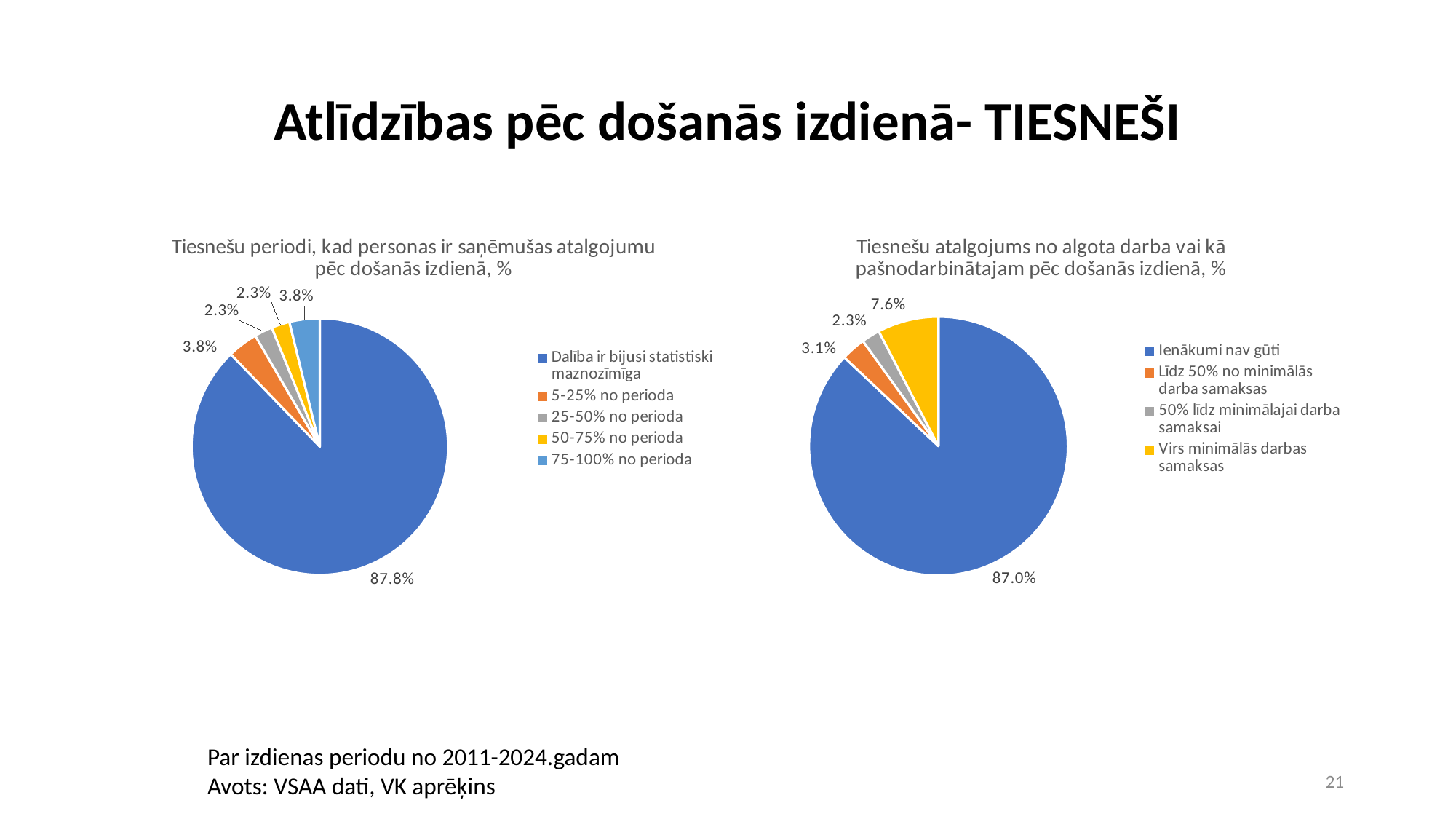
In the left chart, what share is shown for '5-25% no perioda'? 3.8% In the right chart (Tiesnešu atalgojums no algota darba vai kā pašnodarbinātajam pēc došanās izdienā, %), what share is shown for 'Ienākumi nav gūti'? 87.0% What type of chart is used on the left side of the slide? Pie chart In the left chart, how many slices does the pie have? 5 In the left chart, which category has the largest slice? Dalība ir bijusi statistiski maznozīmīga In the right chart, what is the difference between the 'Virs minimālās darbas samaksas' share and the 'Līdz 50% no minimālās darba samaksas' share? 4.5% In the right chart, how many entries does the legend list? 4 In the left chart, what share is shown for '50-75% no perioda'? 2.3% In the right chart, what share is shown for 'Virs minimālās darbas samaksas'? 7.6% In the right chart, what share is shown for 'Līdz 50% no minimālās darba samaksas'? 3.1% In the left chart (Tiesnešu periodi, kad personas ir saņēmušas atalgojumu pēc došanās izdienā, %), what share is labelled for 'Dalība ir bijusi statistiski maznozīmīga'? 87.8% In the right chart, which category has the smallest slice? 50% līdz minimālajai darba samaksai